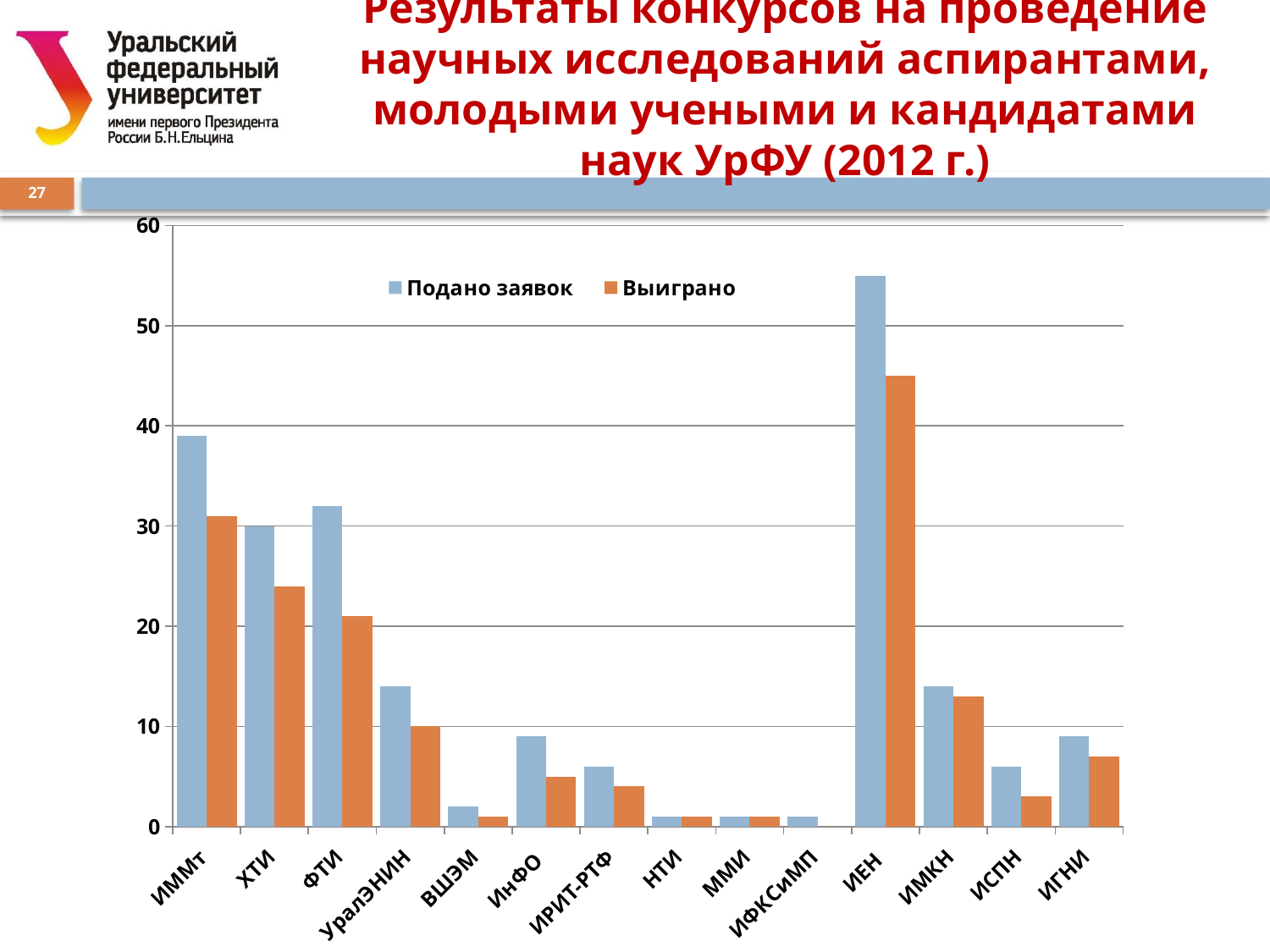
Which is larger: Выиграно for ИМКН or Выиграно for ИСПН? ИМКН What colour are the bars for the Выиграно series? orange Which category has the highest value for Подано заявок? ИЕН Is the value of Подано заявок for ИЕН greater or less than 50? greater What kind of chart is shown on the slide? bar chart Is the value of Выиграно for ИЕН greater or less than 40? greater How many categories (institutes) are shown on the x axis? 14 Is the value of Выиграно for ФТИ greater or less than 30? less How many series does the legend list? 2 Which category has the highest value for Выиграно? ИЕН Which is larger: Подано заявок for ИММт or Подано заявок for ХТИ? ИММт